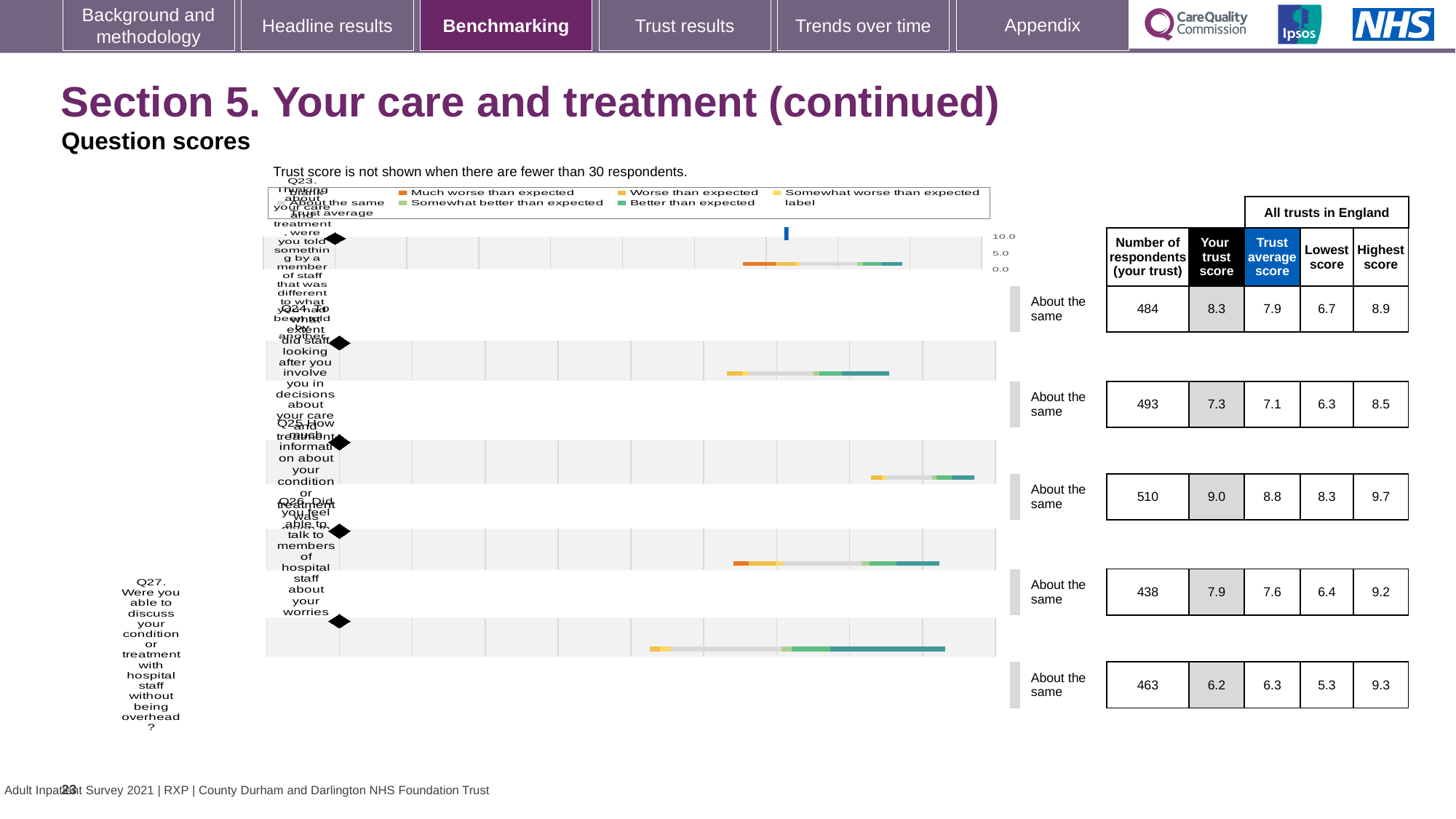
According to the note above the chart, when is the trust score not shown? When there are fewer than 30 respondents Which question has the highest 'Your trust score' on this slide? Q25 How many questions are plotted in the chart on this slide? 5 What is the 'Lowest score' among all trusts in England for Q24? 6.3 How many respondents from your trust answered Q27 (discussing your condition without being overheard)? 463 Which question has the lowest 'Your trust score' on this slide? Q27 What is the 'Highest score' among all trusts in England for Q25? 9.7 What benchmark category is shown next to the chart for Q23? About the same What is the difference between 'Your trust score' and the 'Trust average score' for Q23? 0.4 What kind of chart is used to show the question scores on this slide? Bar chart What is the 'Your trust score' for Q24 (involving you in decisions about your care and treatment)? 7.3 For Q26, which is larger: 'Your trust score' or the 'Trust average score'? Your trust score